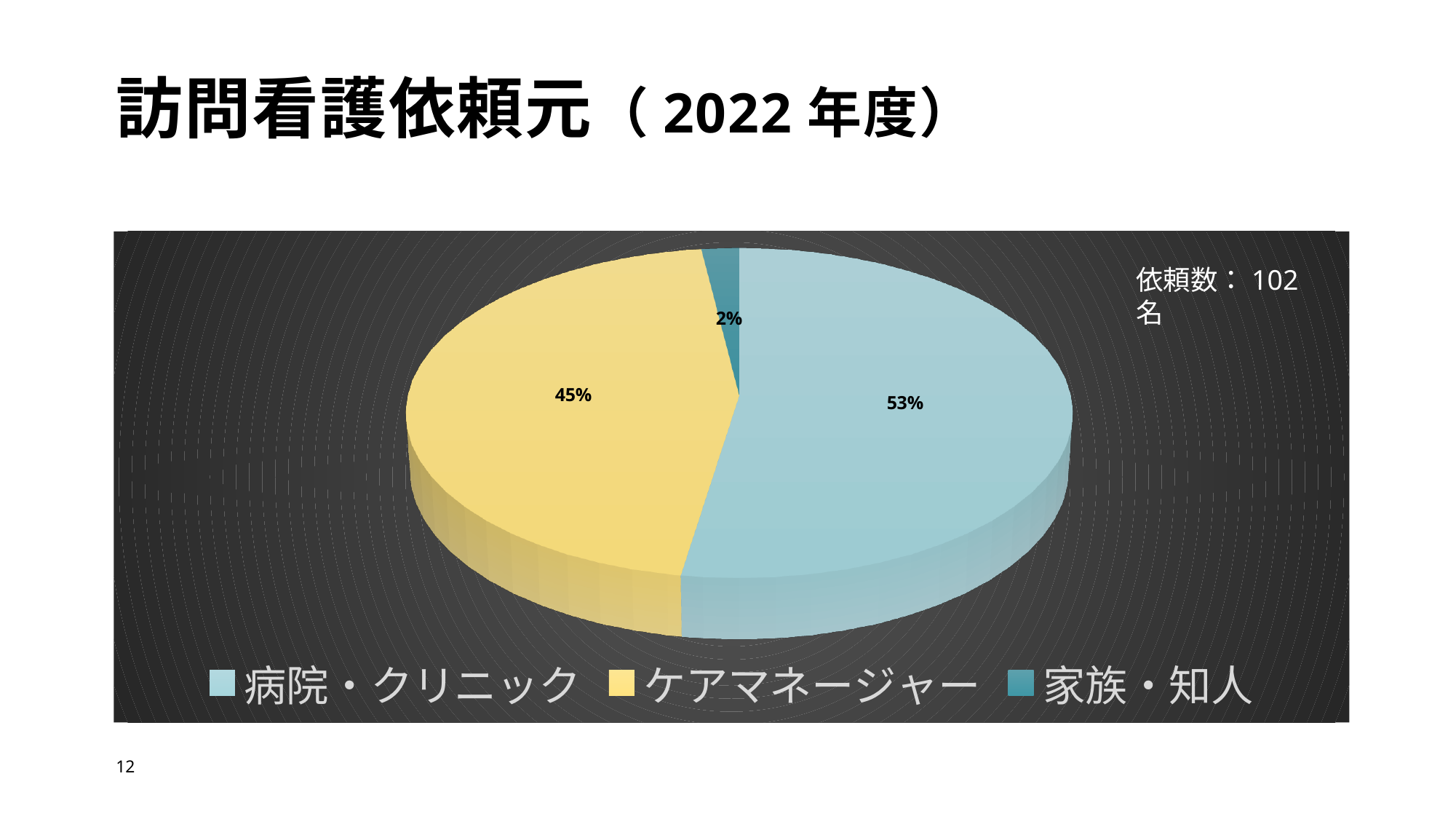
What share of the pie does 病院・クリニック have? 53% How many categories does the pie chart show? 3 What share of the pie does ケアマネージャー have? 45% Which is larger, the share for ケアマネージャー or the share for 家族・知人? ケアマネージャー Which colour represents 家族・知人 in the legend? teal Which category has the smallest slice of the pie? 家族・知人 What share of the pie does 家族・知人 have? 2% Which category has the largest slice of the pie? 病院・クリニック What is the difference in percentage points between ケアマネージャー and 家族・知人? 43 What is the difference in percentage points between 病院・クリニック and ケアマネージャー? 8 What is the total number of requests (依頼数) stated on the slide? 102名 What kind of chart is shown on the slide? pie chart